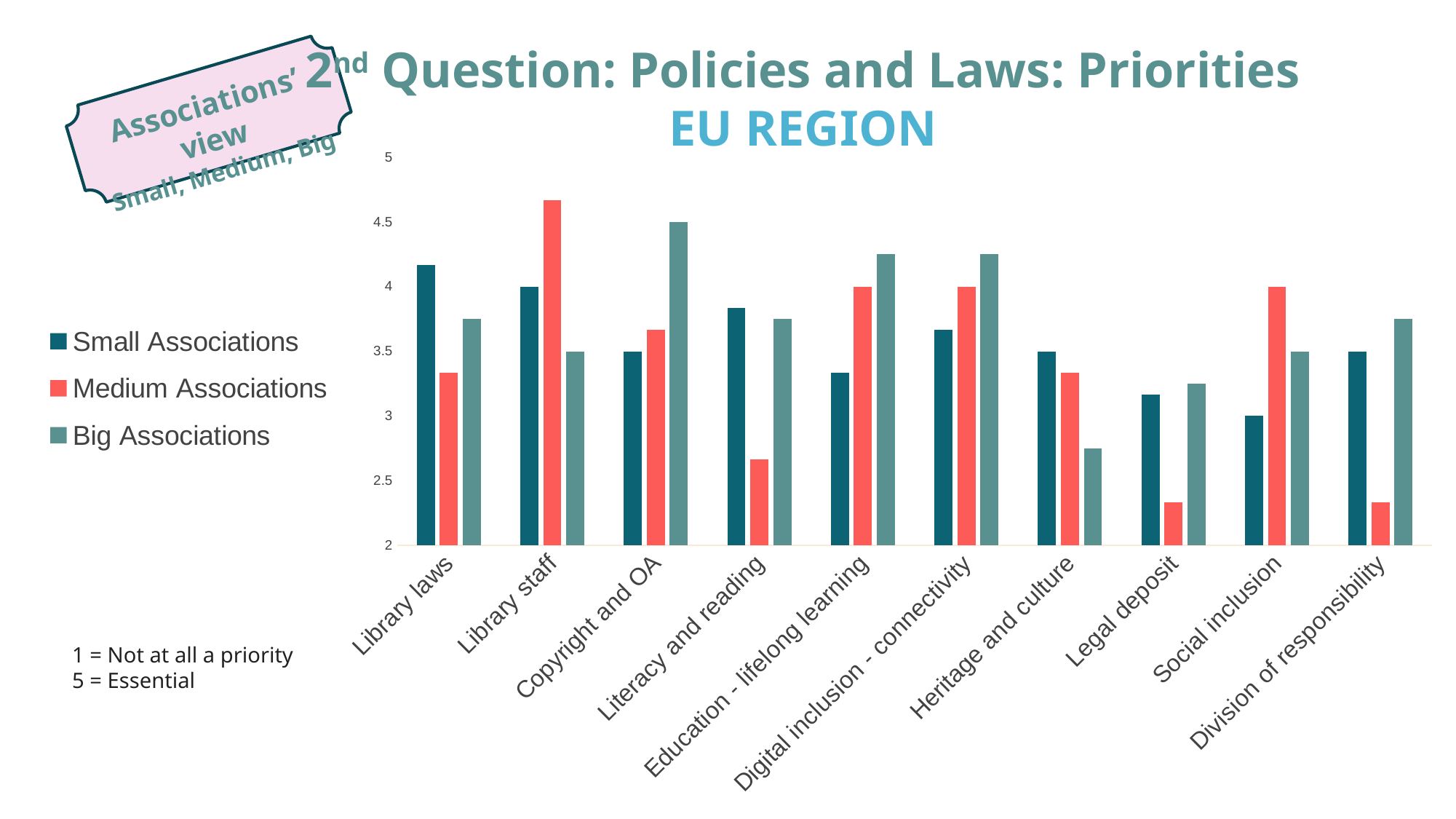
For Library laws, which is larger: the Small Associations value or the Medium Associations value? Small Associations Is the Medium Associations value for Literacy and reading greater or less than 3? less How many categories are shown along the x axis? 10 Is the Medium Associations value for Library staff greater or less than 4.5? greater For which category is the Big Associations value highest? Copyright and OA What kind of chart is shown on the slide? Bar chart How many series does the legend list? 3 For which category is the Medium Associations value highest? Library staff For which category is the Big Associations value lowest? Heritage and culture For Social inclusion, which is larger: the Medium Associations value or the Small Associations value? Medium Associations For which category is the Small Associations value lowest? Social inclusion Is the Small Associations value for Library laws greater or less than 4? greater